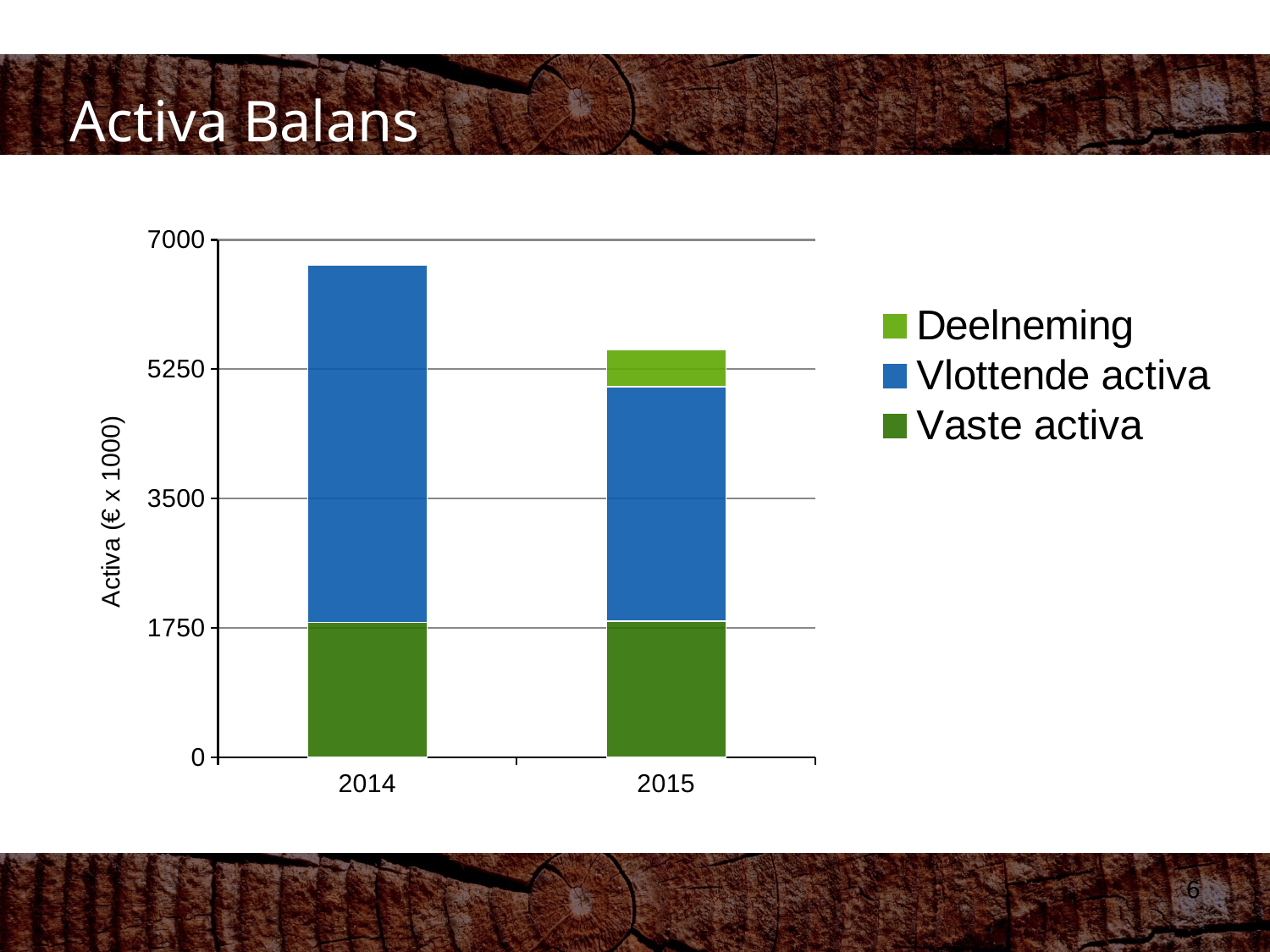
What kind of chart is shown on the slide? bar chart Is the total of the 2015 bar greater or less than 5250? greater Is the Vlottende activa segment for 2015 greater or less than 3500? less Which year has the taller stacked bar, 2014 or 2015? 2014 How many categories are shown on the x axis? 2 Which year has the larger Vlottende activa segment, 2014 or 2015? 2014 How many series does the legend list? 3 Does the total of the stacked bars rise or fall from 2014 to 2015? fall Is the total of the 2014 bar greater or less than 7000? less Which series appears only in the 2015 bar and not in the 2014 bar? Deelneming What is the label of the vertical axis? Activa (€ x 1000)